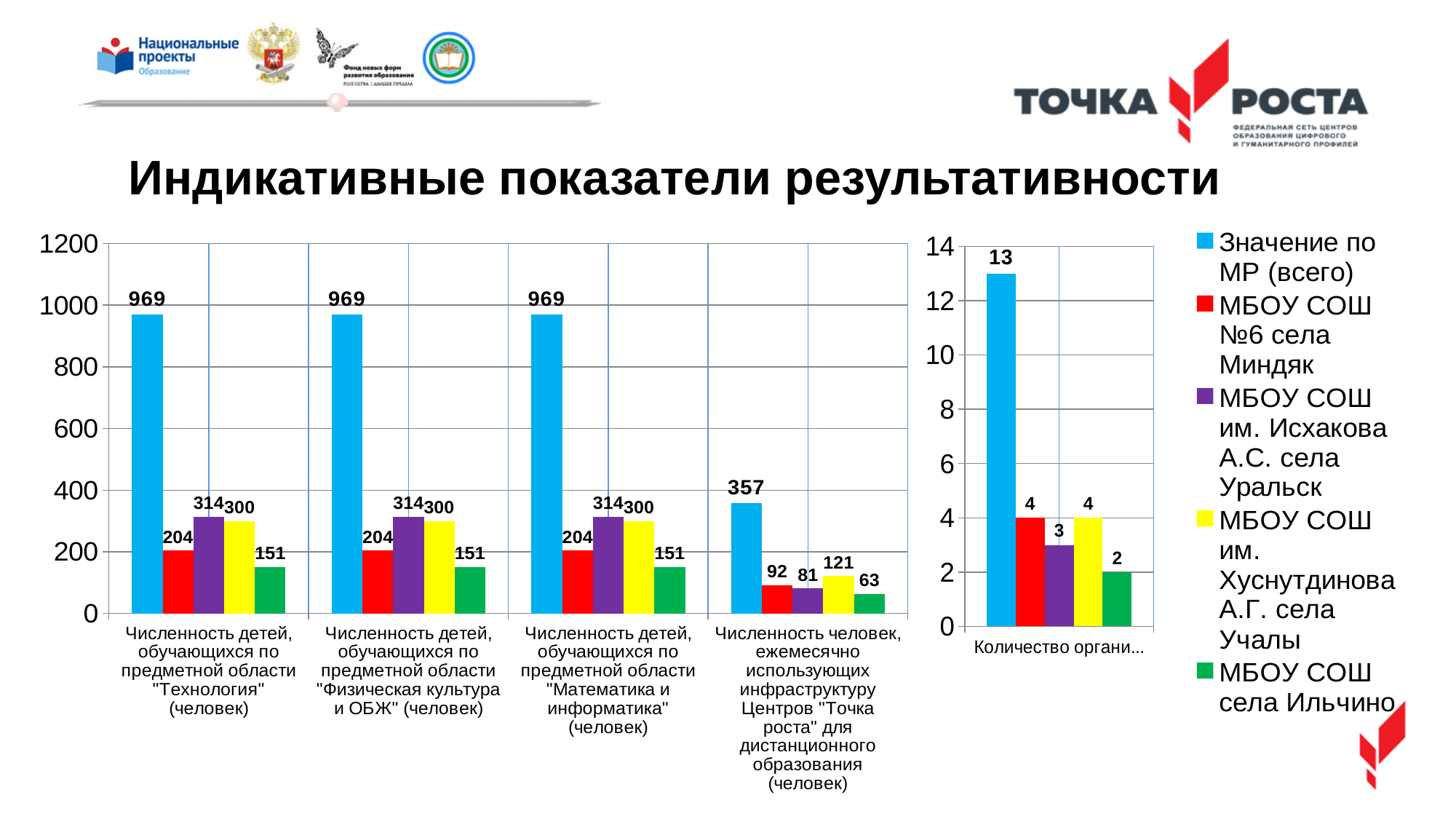
On the right chart, what is the value for Значение по МР (всего)? 13 On the left chart, what is the value for МБОУ СОШ №6 села Миндяк in the category "Численность детей, обучающихся по предметной области "Технология" (человек)"? 204 What kind of chart is the right chart? bar chart On the left chart, what is the value for МБОУ СОШ им. Хуснутдинова А.Г. села Учалы in the category "Численность детей, обучающихся по предметной области "Математика и информатика" (человек)"? 300 On the left chart, in the category "Численность человек, ежемесячно использующих инфраструктуру Центров "Точка роста" для дистанционного образования (человек)", which is larger: the value for МБОУ СОШ №6 села Миндяк or for МБОУ СОШ им. Хуснутдинова А.Г. села Учалы? МБОУ СОШ им. Хуснутдинова А.Г. села Учалы On the right chart, what is the difference between the values for Значение по МР (всего) and МБОУ СОШ села Ильчино? 11 On the left chart, what is the difference between the values for МБОУ СОШ им. Исхакова А.С. села Уральск and МБОУ СОШ села Ильчино in the category "Численность детей, обучающихся по предметной области "Физическая культура и ОБЖ" (человек)"? 163 How many categories are shown on the x axis of the left chart? 4 On the left chart, what is the value for Значение по МР (всего) in the category "Численность человек, ежемесячно использующих инфраструктуру Центров "Точка роста" для дистанционного образования (человек)"? 357 On the left chart, which series has the lowest value in the category "Численность человек, ежемесячно использующих инфраструктуру Центров "Точка роста" для дистанционного образования (человек)"? МБОУ СОШ села Ильчино How many series does the legend list? 5 On the right chart, what is the value for МБОУ СОШ им. Исхакова А.С. села Уральск? 3